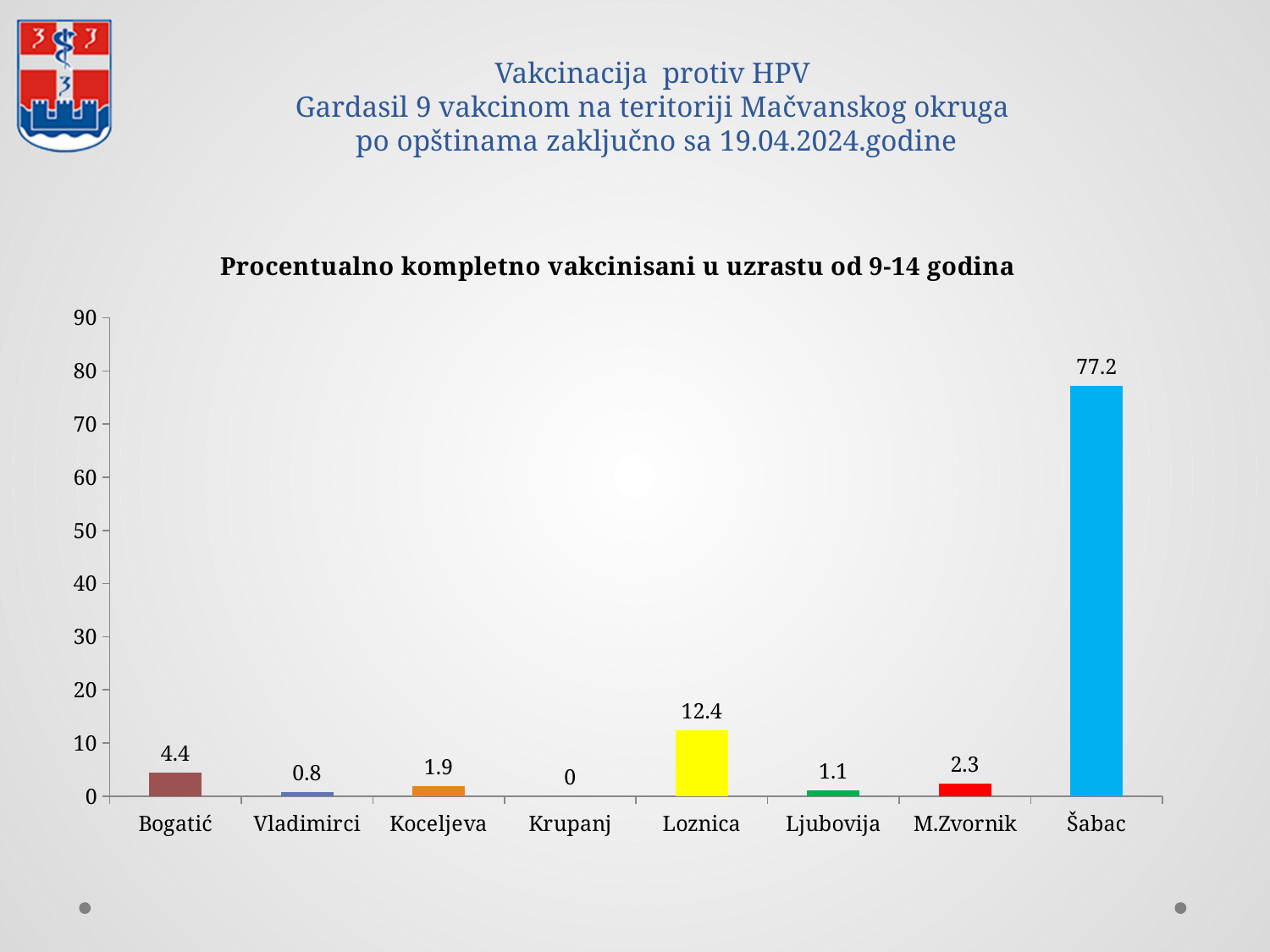
What is the value for Loznica? 12.4 Which is larger, the value for Bogatić or the value for M.Zvornik? Bogatić What is the value for Šabac? 77.2 Which category has the highest value? Šabac What is the value for Krupanj? 0 What is the difference between the values for Šabac and Loznica? 64.8 Which category has the lowest value? Krupanj What kind of chart is shown on the slide? bar chart What is the value for Bogatić? 4.4 What is the title of the chart? Procentualno kompletno vakcinisani u uzrastu od 9-14 godina How many categories are shown on the x axis? 8 Is the value for Šabac greater or less than 70? greater